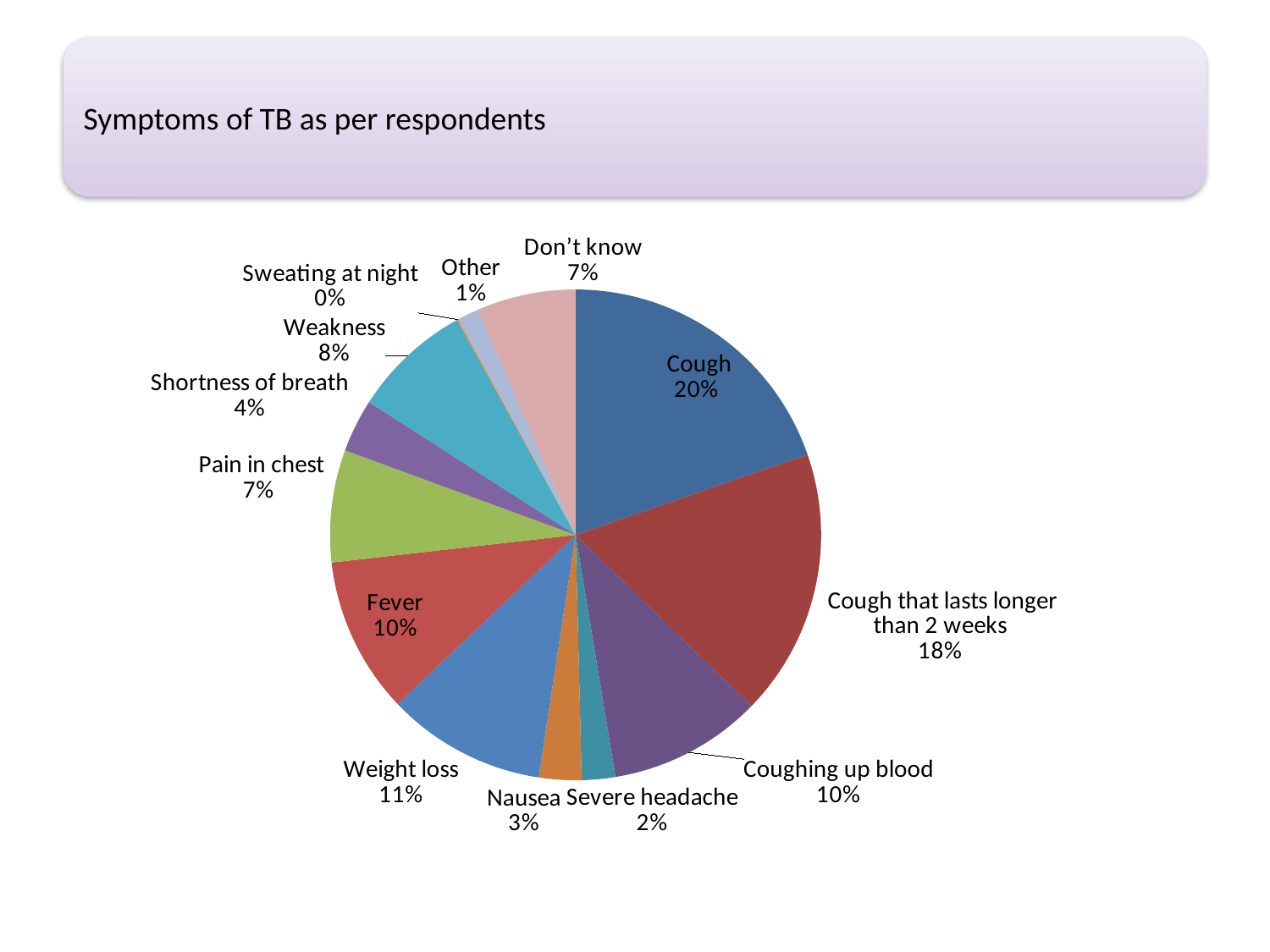
Which category has the smallest slice of the pie? Sweating at night What share of the pie does Cough account for? 20% Which symptom has the largest slice of the pie? Cough What is the difference between the values for Cough and Cough that lasts longer than 2 weeks? 2% What kind of chart is shown on the slide? Pie chart What is the value for Sweating at night? 0% What is the value for Weight loss? 11% What is the value for Cough that lasts longer than 2 weeks? 18% Which is larger, the value for Weakness or the value for Pain in chest? Weakness How many categories are shown in the pie chart? 13 What is the title of the slide? Symptoms of TB as per respondents What is the difference between the values for Weight loss and Nausea? 8%